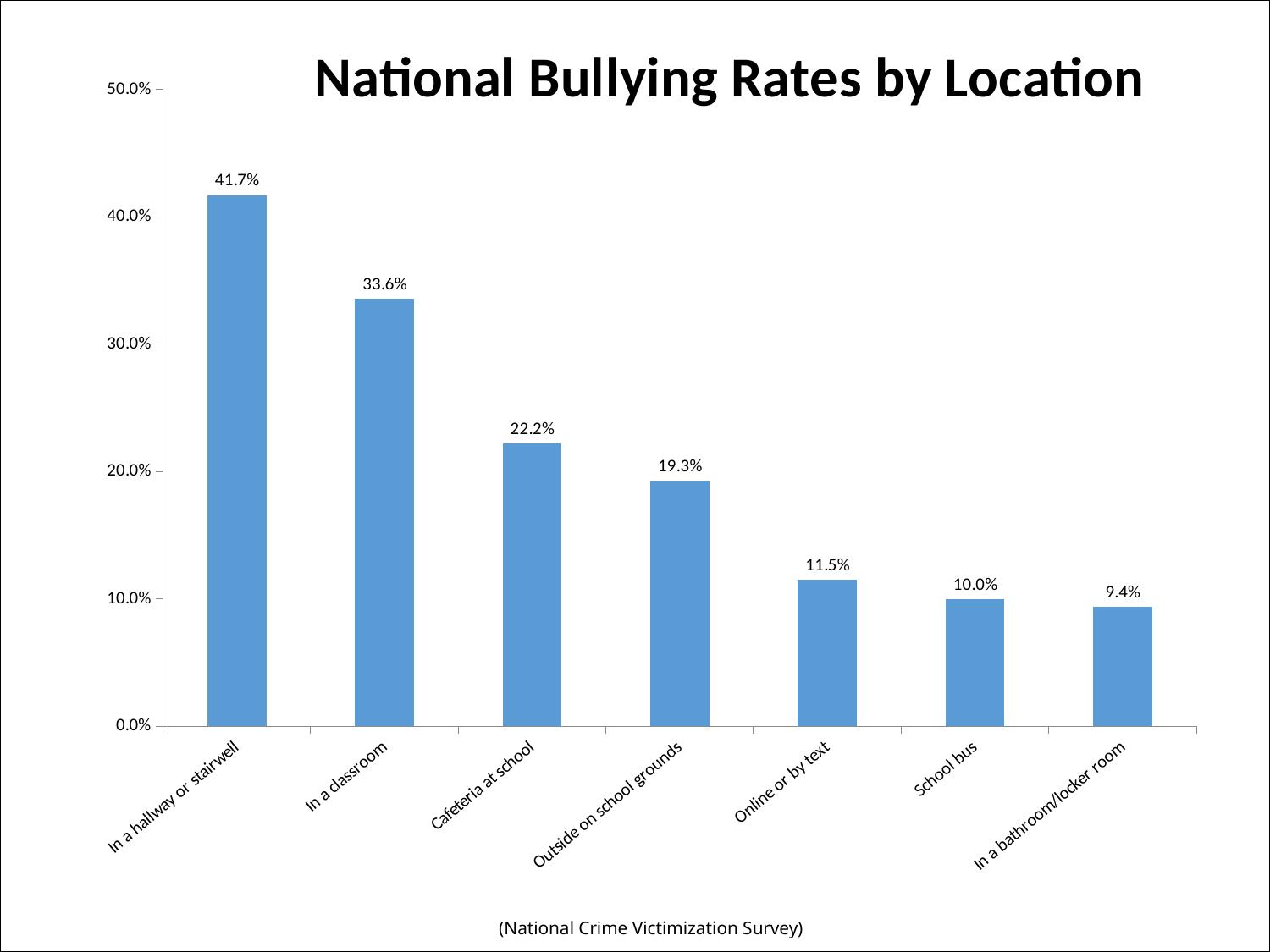
Do the values rise or fall from left to right along the x axis? Fall What is the bullying rate for 'School bus'? 10.0% Which location has the lowest bullying rate? In a bathroom/locker room What is the bullying rate for 'Online or by text'? 11.5% What is the title of the chart? National Bullying Rates by Location How many locations are shown on the chart? 7 What is the bullying rate for 'In a hallway or stairwell'? 41.7% Is the value for 'Cafeteria at school' greater or less than 20.0%? greater Which location has the highest bullying rate? In a hallway or stairwell What kind of chart is shown on the slide? Bar chart What is the difference between the bullying rates for 'In a classroom' and 'Cafeteria at school'? 11.4% Which has a higher bullying rate, 'Outside on school grounds' or 'Online or by text'? Outside on school grounds